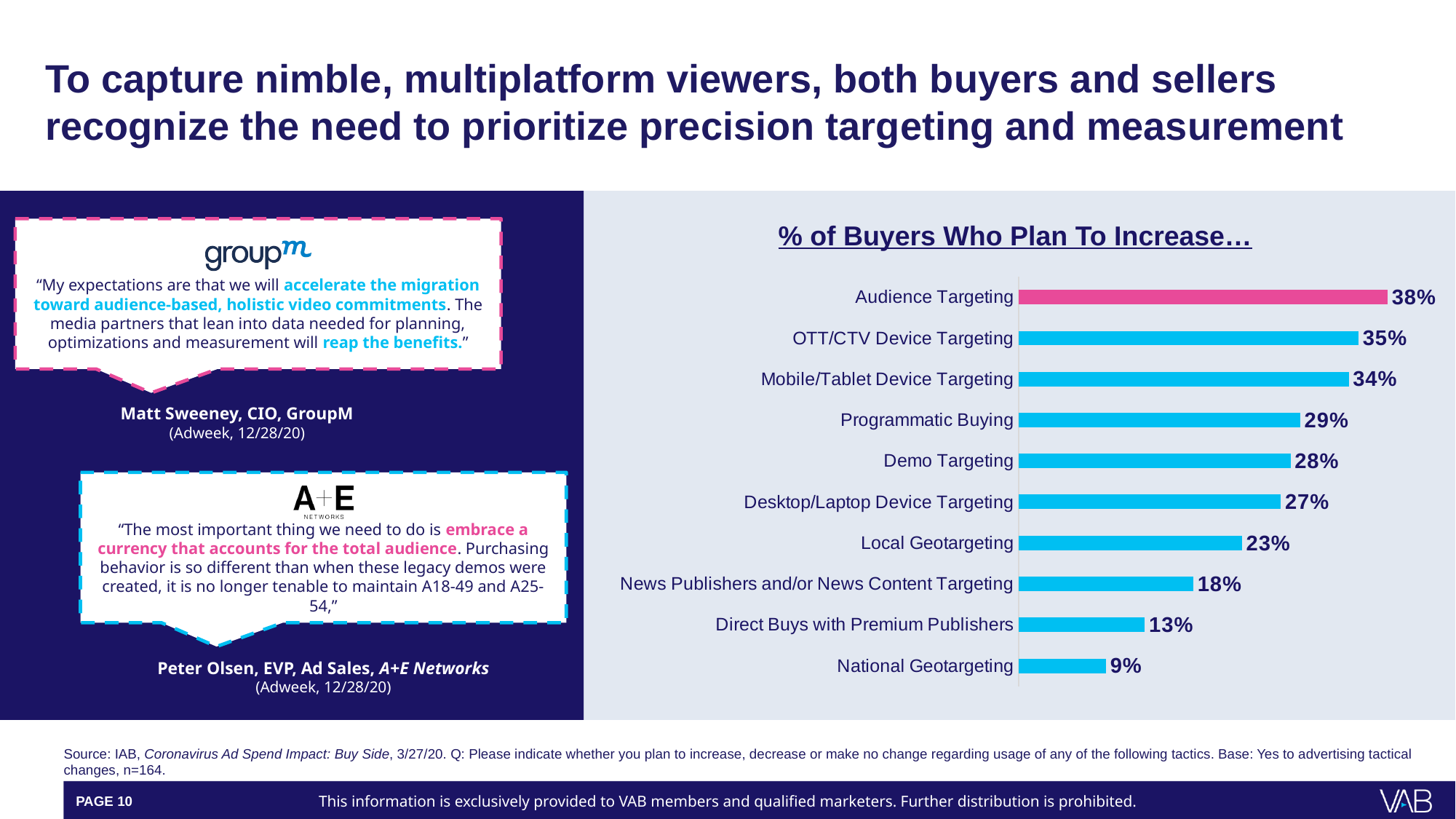
What is the title of the chart? % of Buyers Who Plan To Increase… What percentage of buyers plan to increase Audience Targeting? 38% What is the difference in percentage points between Local Geotargeting and National Geotargeting? 14 percentage points What type of chart is used to show the % of buyers who plan to increase each tactic? Bar chart Which has a higher percentage of buyers planning to increase it: Demo Targeting or Desktop/Laptop Device Targeting? Demo Targeting What is the difference in percentage points between OTT/CTV Device Targeting and Mobile/Tablet Device Targeting? 1 percentage point Which category has the highest percentage of buyers planning to increase it? Audience Targeting Which category has the lowest percentage of buyers planning to increase it? National Geotargeting Which bar in the chart is coloured differently (pink) from the others? Audience Targeting What percentage of buyers plan to increase Programmatic Buying? 29% What percentage of buyers plan to increase Direct Buys with Premium Publishers? 13% How many categories are shown in the chart? 10